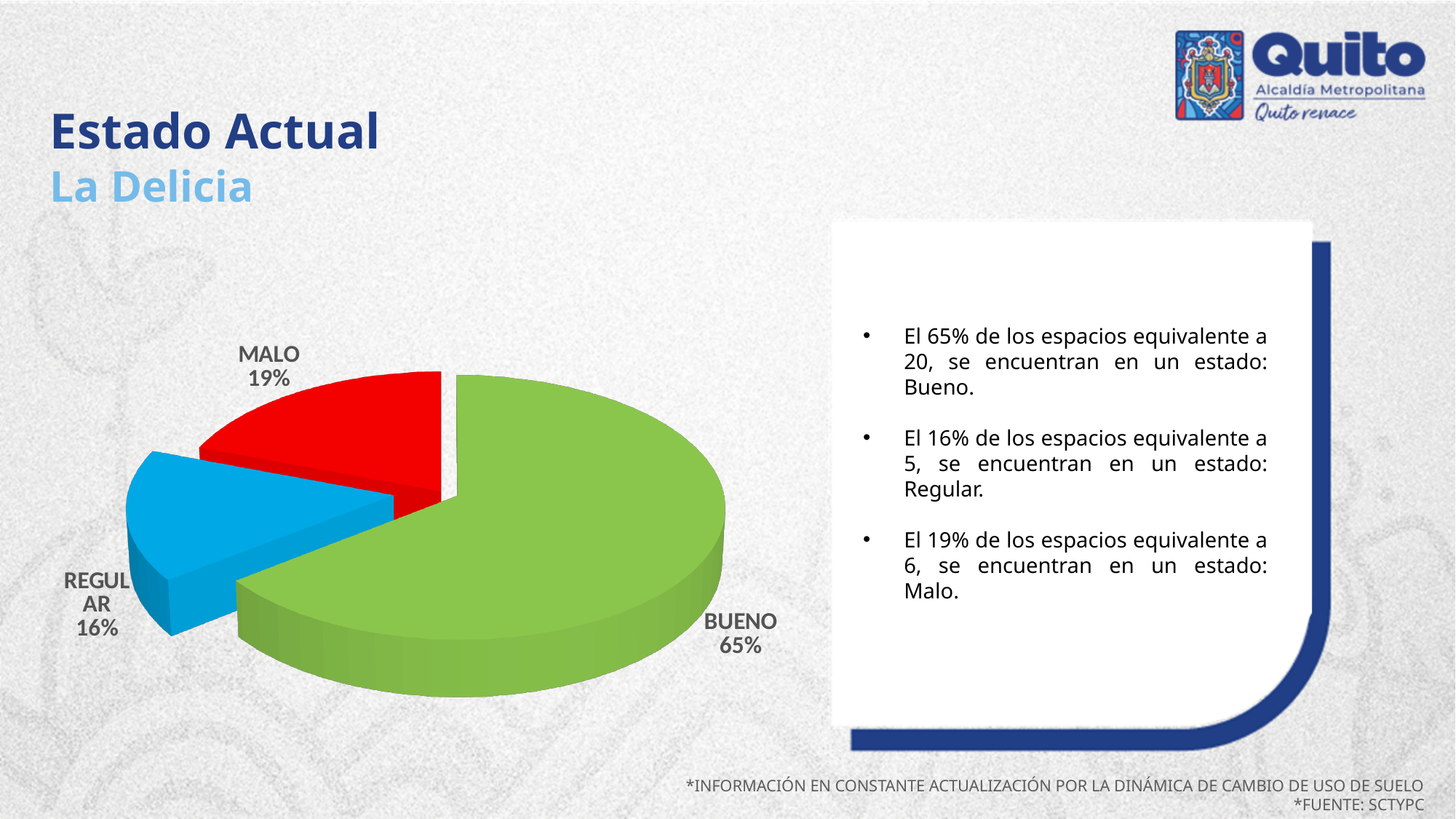
What is the difference in percentage points between MALO and REGULAR? 3 Which category has the smallest share of the pie? REGULAR How many slices does the pie chart have? 3 What kind of chart is shown on the slide? Pie chart What percentage of the pie is labelled REGULAR? 16% Which is larger, the share for MALO or the share for REGULAR? MALO Which category has the largest share of the pie? BUENO What is the difference in percentage points between BUENO and MALO? 46 What colour is the BUENO slice? Green What percentage of the pie is labelled MALO? 19% What colour is the MALO slice? Red What percentage of the pie is labelled BUENO? 65%